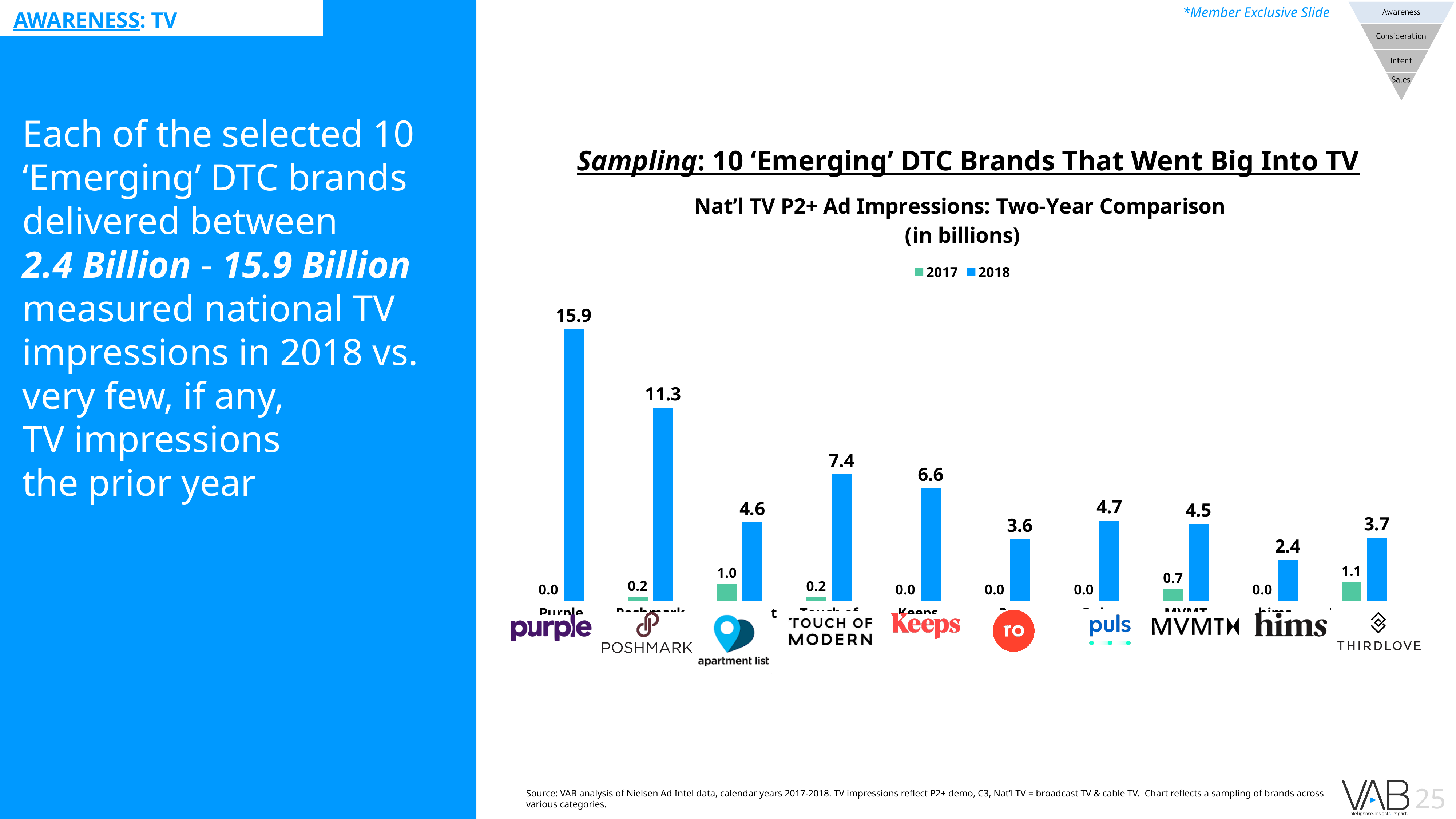
What is the difference between Purple's 2018 value and Poshmark's 2018 value? 4.6 How many series does the chart legend list? 2 Which brand had the highest 2018 value in the chart? Purple What was Poshmark's 2018 value in the chart? 11.3 How many brands are shown in the chart? 10 What was Purple's 2018 national TV ad impressions value (in billions)? 15.9 Which had a larger 2018 value, Touch of Modern or Keeps? Touch of Modern Which brand had the lowest 2018 value in the chart? hims What is the subtitle of the chart below the main heading? Nat'l TV P2+ Ad Impressions: Two-Year Comparison (in billions) What was Apartment List's 2017 value in the chart? 1.0 What kind of chart is shown on the slide? Bar chart What was MVMT's 2017 value in the chart? 0.7